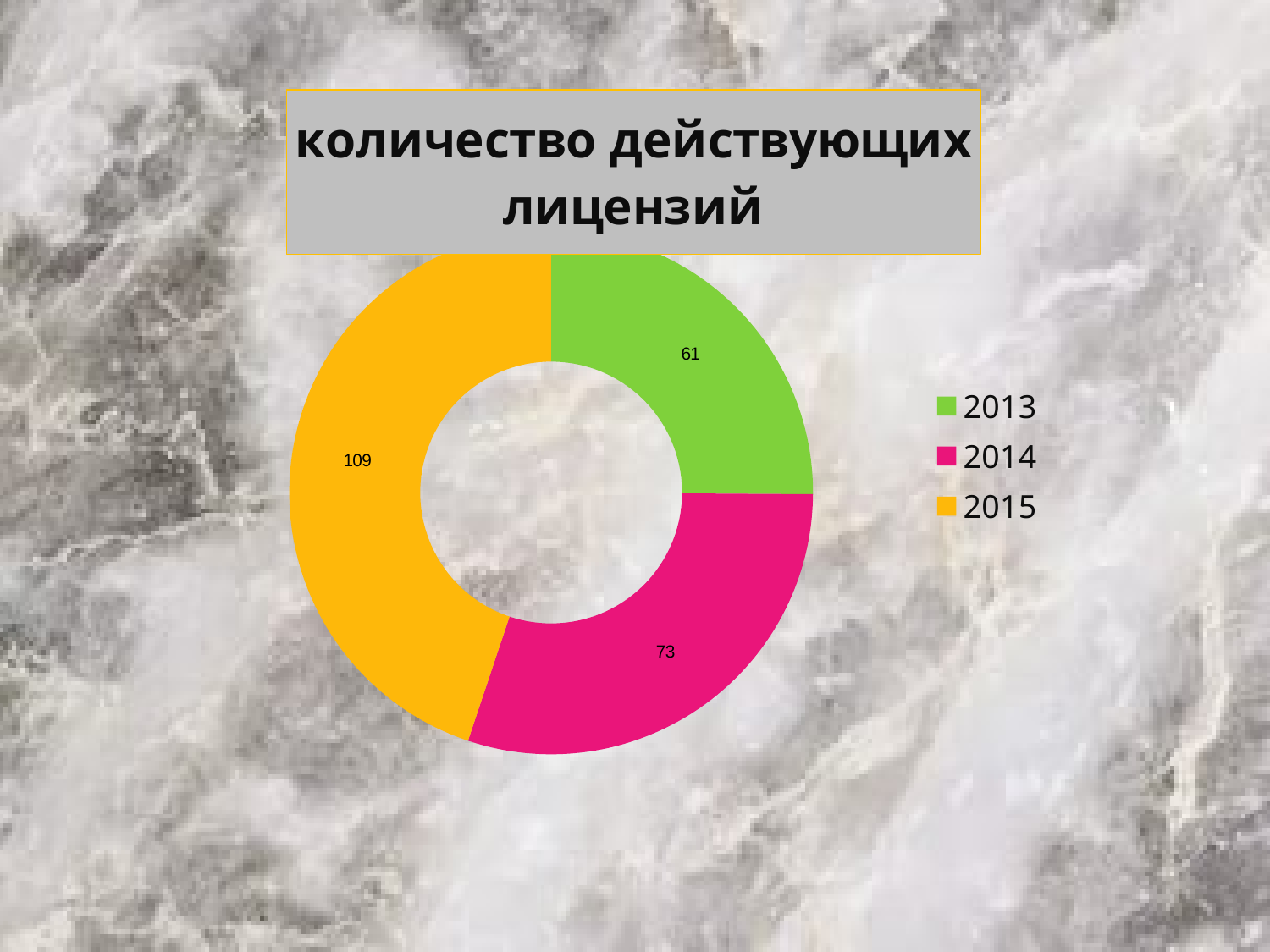
How many categories does the chart show? 3 What is the total of all values in the chart? 243 What type of chart is shown on the slide? Doughnut chart What is the difference between the values for 2015 and 2014? 36 Which is larger, the value for 2014 or the value for 2013? 2014 What is the title of the chart? количество действующих лицензий What is the value for 2013? 61 What is the value for 2014? 73 Which year has the lowest value? 2013 What is the value for 2015? 109 What is the difference between the values for 2014 and 2013? 12 Which year has the highest value? 2015